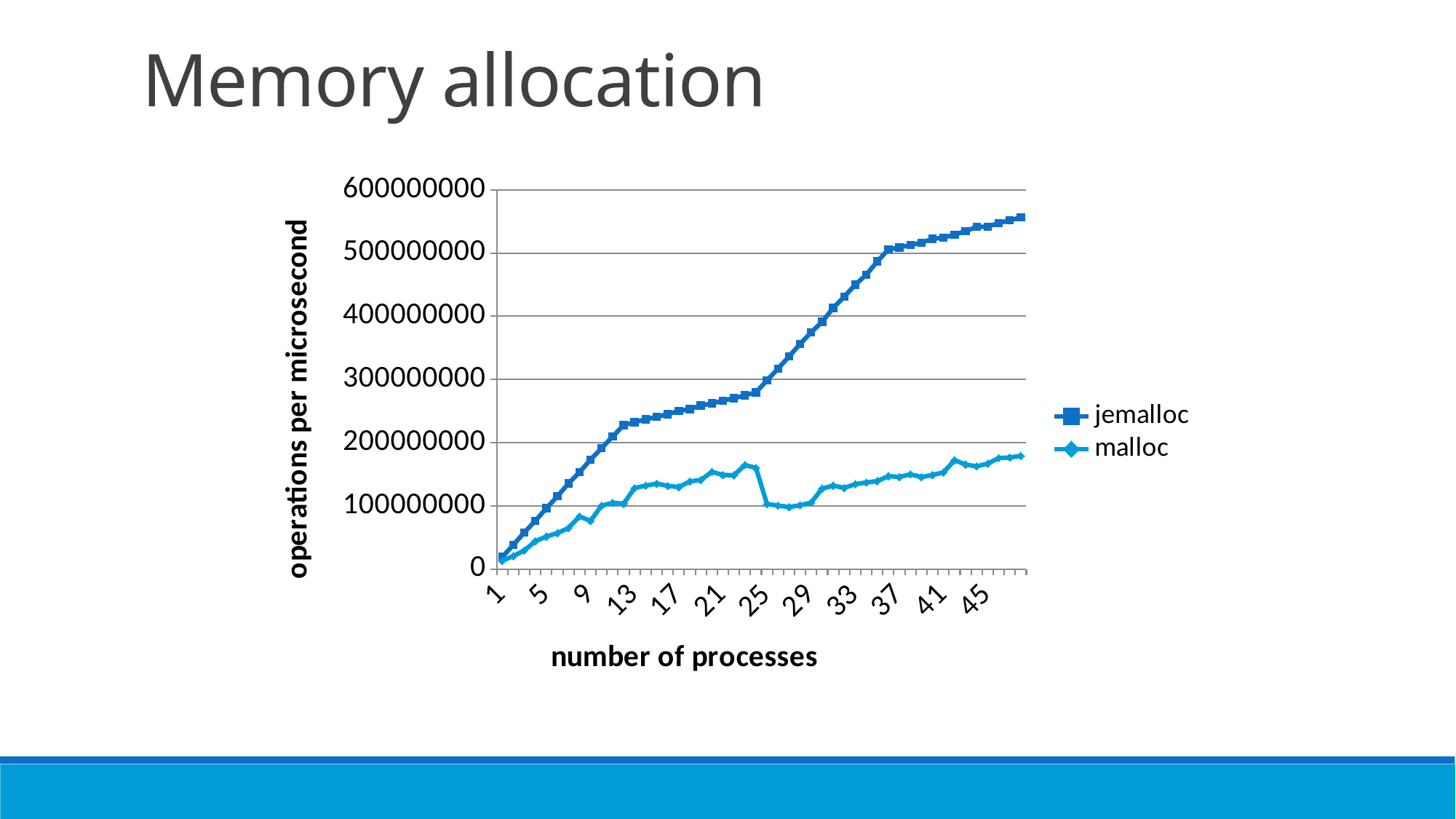
At 37 processes, which series has the larger value, jemalloc or malloc? jemalloc Do the jemalloc values rise or fall as the number of processes increases? rise Is the value for malloc at 29 processes greater or less than 200000000? less Is the value for jemalloc at 13 processes greater or less than 200000000? greater What is the title of the y axis? operations per microsecond Is the value for malloc at 45 processes greater or less than 300000000? less What are the two series named in the legend? jemalloc and malloc How many series does the legend list? 2 What kind of chart is shown on the slide? line chart Which series reaches the highest value on the chart? jemalloc